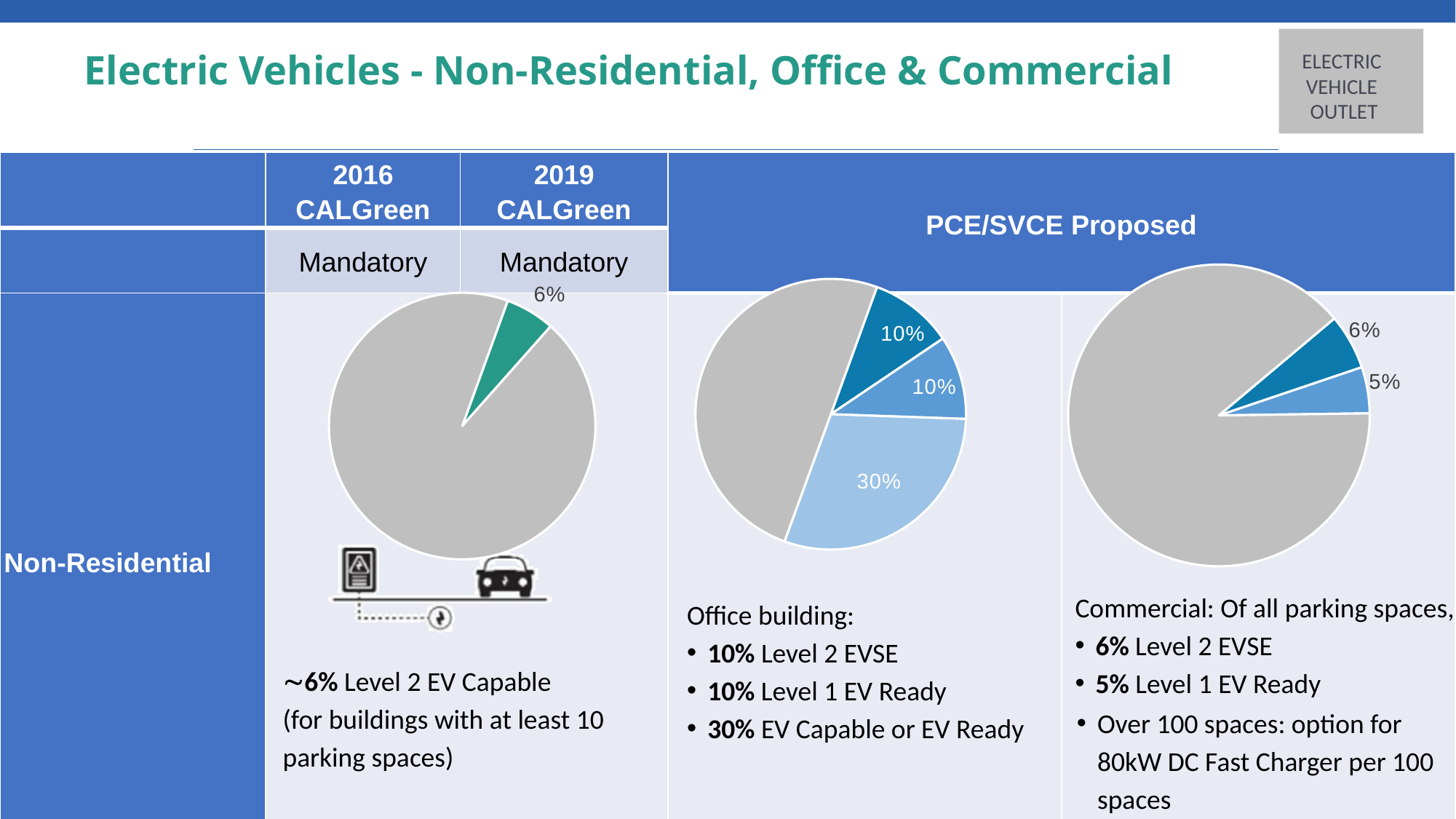
In the middle pie chart (Office building), what is the difference between the 30% slice and one of the 10% slices? 20% In the right pie chart (Commercial), what percentage is shown for the Level 1 EV Ready slice? 5% In the left pie chart (CALGreen Mandatory), what percentage is shown for the green slice? 6% In the right pie chart (Commercial), which labelled slice is larger, 6% or 5%? 6% In the middle pie chart (Office building), how many slices have printed percentage labels? 3 In the right pie chart (Commercial), what percentage is shown for the Level 2 EVSE slice? 6% In the middle pie chart (Office building), what is the largest labelled slice value? 30% In the right pie chart (Commercial), what is the combined share of the two labelled slices? 11% In the middle pie chart (Office building), is the 30% slice greater or less than 25%? greater What kind of chart is shown in the left column under the CALGreen Mandatory heading? pie chart How many pie charts are shown on the slide? 3 In the middle pie chart (Office building), what is the combined share of the three labelled slices? 50%